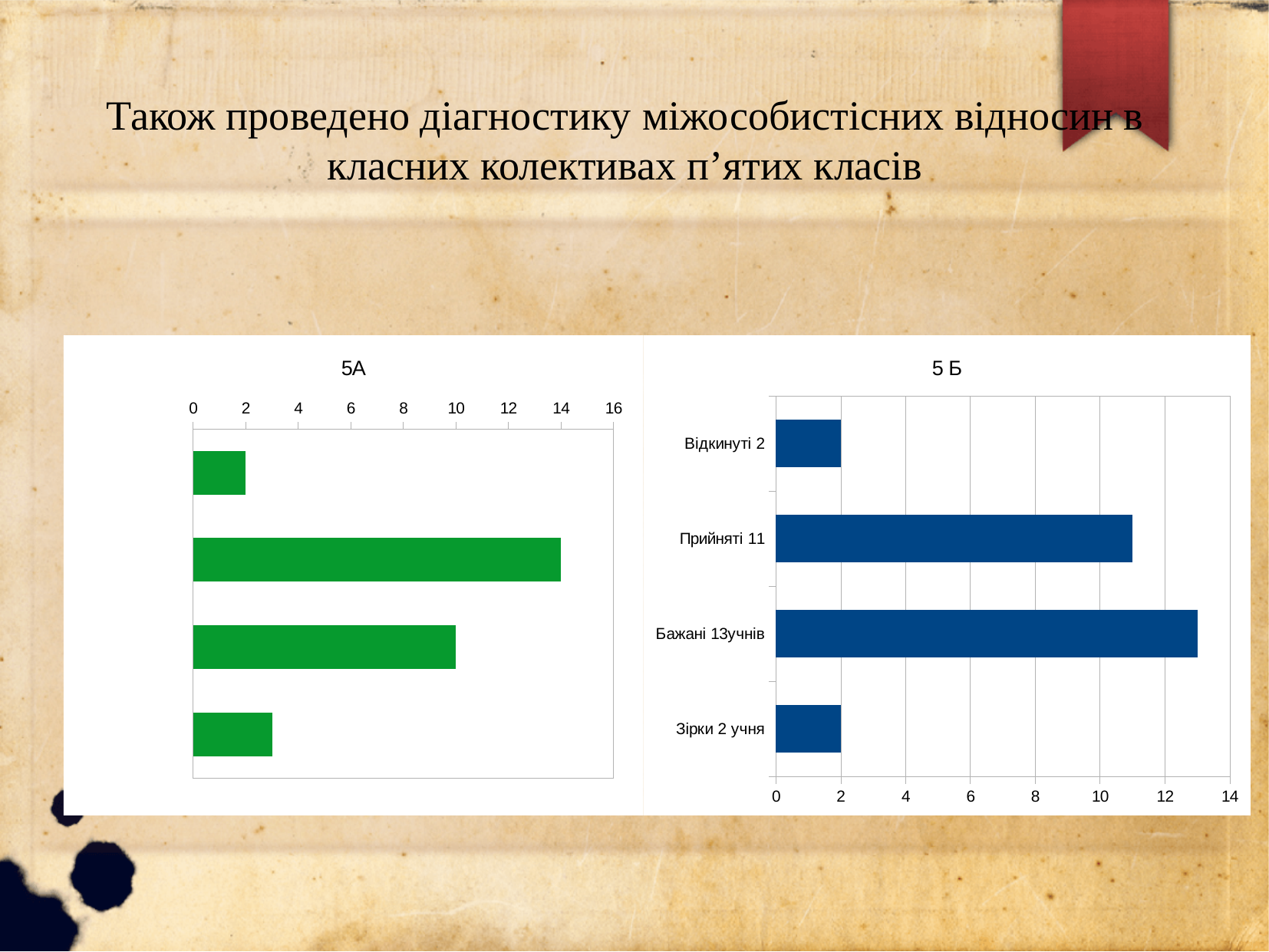
How many categories are shown in the 5 Б chart? 4 In the 5 Б chart, what is the value for Бажані? 13 In the 5 Б chart, which category has the highest value? Бажані In the 5 Б chart, is the value for Прийняті greater or less than 10? greater What is the title of the chart on the right side of the slide? 5 Б In the 5 Б chart, what is the difference between the values for Бажані and Прийняті? 2 In the 5 Б chart, what is the value for Відкинуті? 2 What kind of chart is the 5А chart on the left? bar chart How many bars are shown in the 5А chart on the left? 4 What is the largest value shown in the 5А chart on the left? 14 In the 5 Б chart, which is larger: the value for Прийняті or the value for Зірки? Прийняті In the 5 Б chart, what is the value for Прийняті? 11